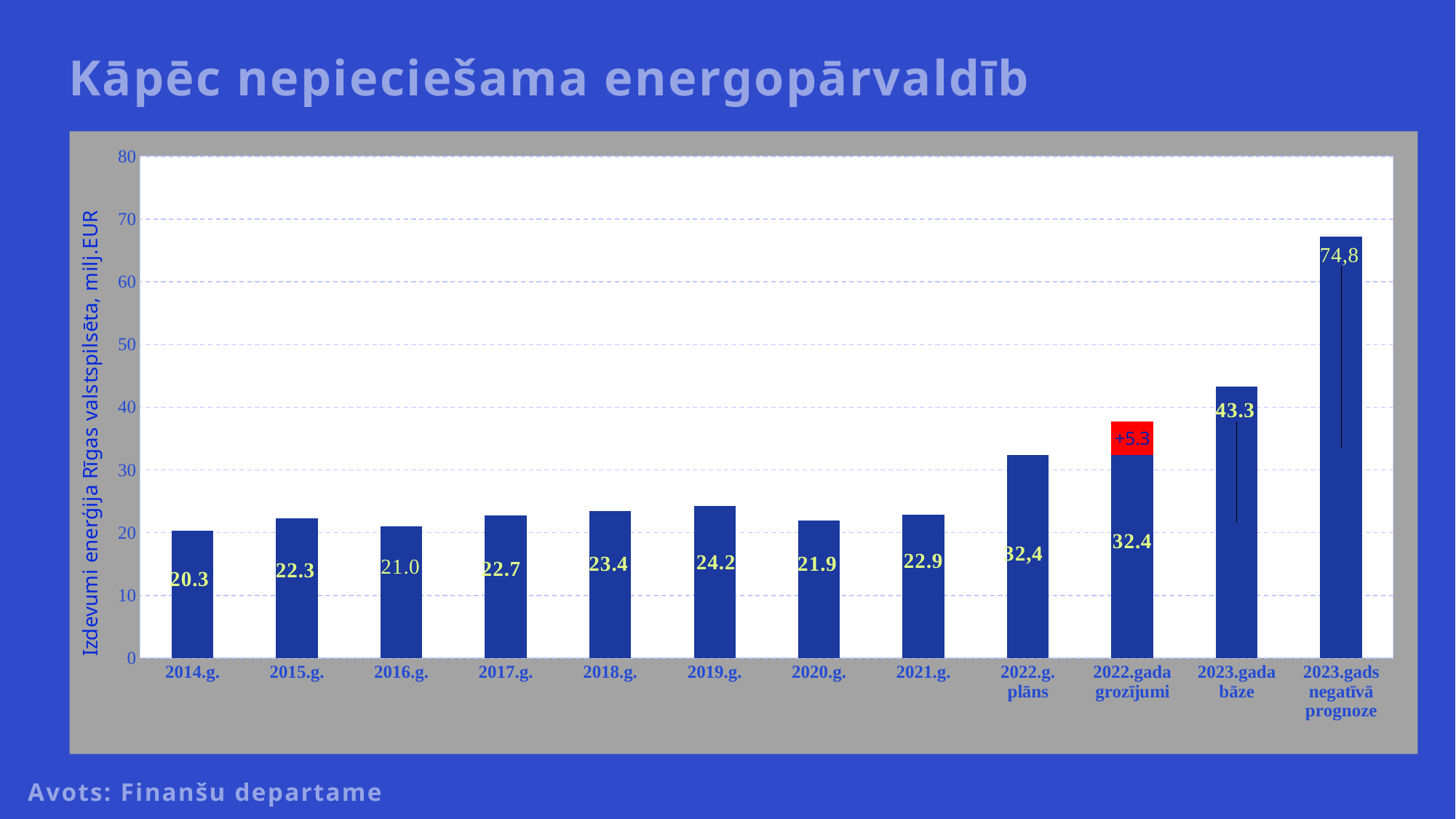
What is the value for 2023.gada bāze? 43.3 Is the value for 2022.g. plāns greater or less than 30? greater Which category has the lowest value? 2014.g. What kind of chart is shown on the slide? bar chart How many categories are shown along the x axis of the chart? 12 Which is larger, the value for 2015.g. or the value for 2016.g.? 2015.g. What is the value for 2014.g.? 20.3 What is the total of the stacked bar for 2022.gada grozījumi? 37.7 What is the value for 2019.g.? 24.2 What value is printed on the red segment of the 2022.gada grozījumi bar? +5.3 What is the difference between the values for 2019.g. and 2014.g.? 3.9 Which category has the highest value? 2023.gads negatīvā prognoze